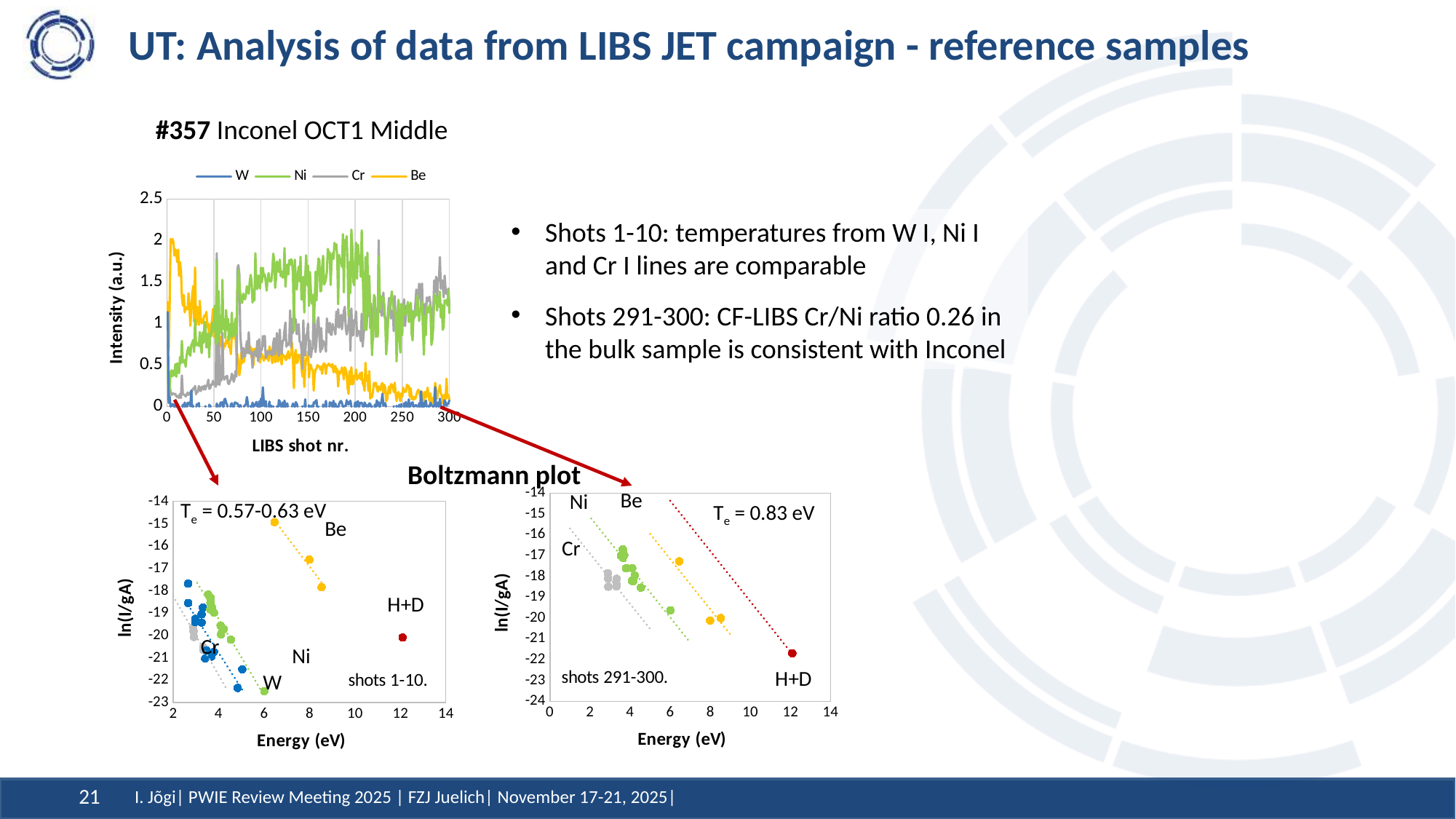
In the top-left chart '#357 Inconel OCT1 Middle', at shot 200 which series has the larger intensity, Ni or W? Ni In the top-left chart '#357 Inconel OCT1 Middle', which series has the lowest intensity across the shots? W How many labelled species are shown in the bottom-left Boltzmann plot (shots 1-10)? 5 What electron temperature is printed on the bottom-right Boltzmann plot for shots 291-300? 0.83 eV What kind of chart is the top-left chart titled '#357 Inconel OCT1 Middle'? line chart In the top-left chart '#357 Inconel OCT1 Middle', what is the label of the x axis? LIBS shot nr. In the top-left chart '#357 Inconel OCT1 Middle', what is the highest value shown on the y axis? 2.5 In the top-left chart '#357 Inconel OCT1 Middle', does the Be intensity rise or fall as the LIBS shot number increases? fall In the bottom-right Boltzmann plot (shots 291-300), is the ln(I/gA) value of the H+D point greater or less than -21? less What electron temperature is printed on the bottom-left Boltzmann plot for shots 1-10? 0.57-0.63 eV In the top-left chart titled '#357 Inconel OCT1 Middle', how many series does the legend list? 4